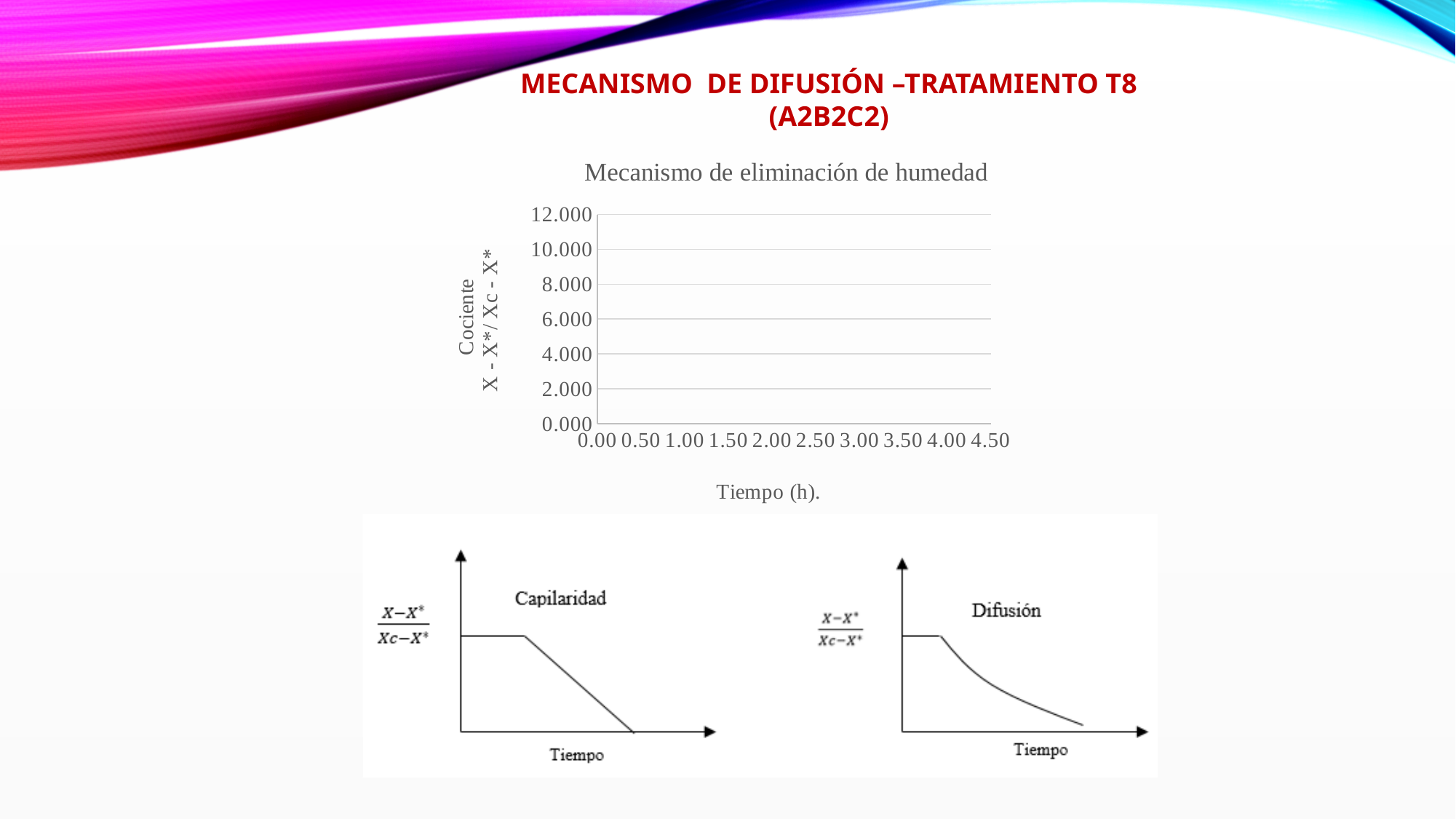
In the 'Capilaridad' diagram at the bottom left of the slide, does the line rise or fall as time increases after the initial flat section? falls In the 'Difusión' diagram at the bottom right of the slide, does the curve rise or fall as time increases after the initial flat section? falls What is the label of the x axis of the chart titled 'Mecanismo de eliminación de humedad'? Tiempo (h). What is the title of the chart on the slide? Mecanismo de eliminación de humedad